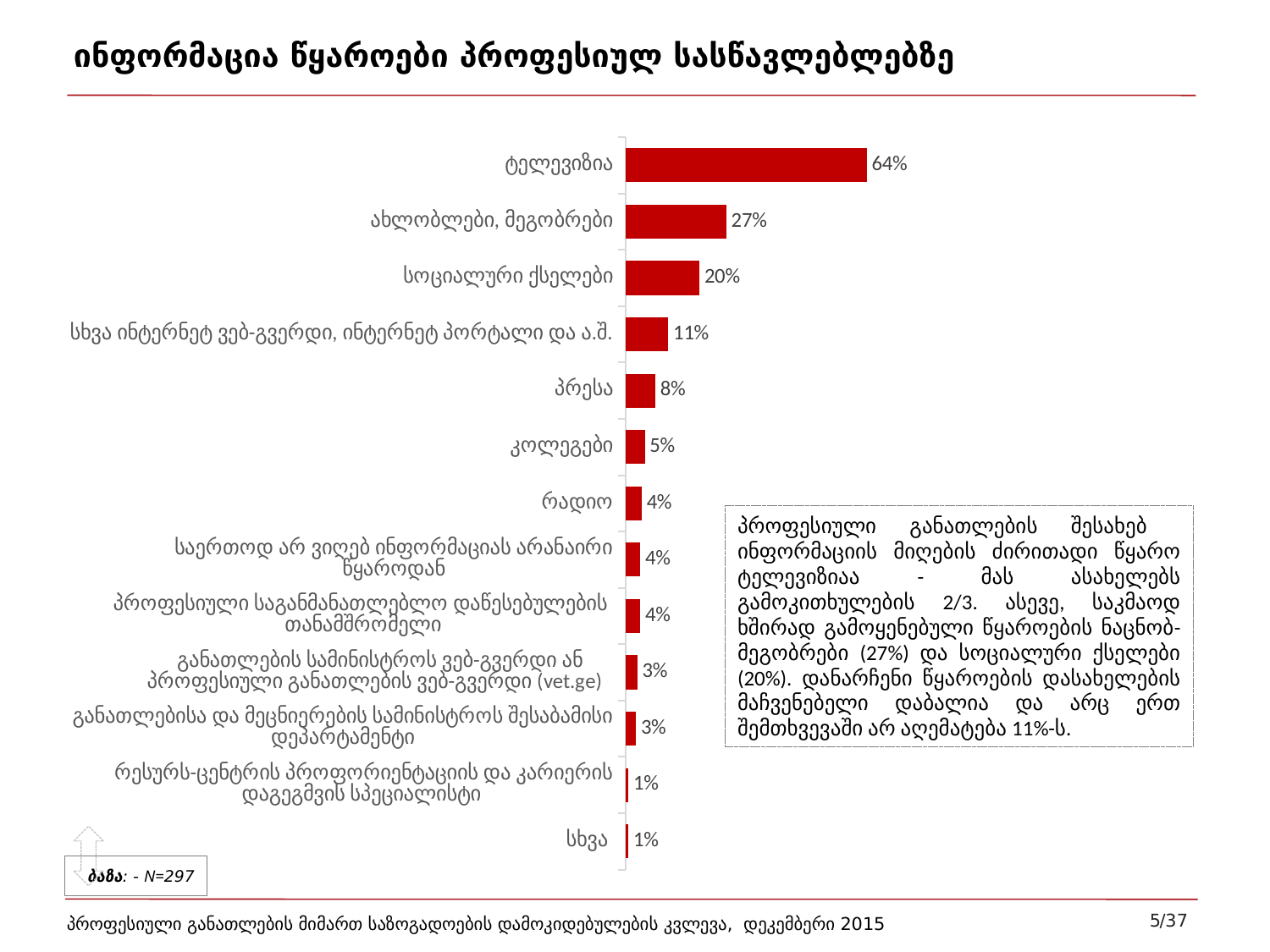
What type of chart is shown on the slide? Bar chart What value is shown for სოციალური ქსელები? 20% How many categories are shown in the chart? 13 What percentage is shown for პრესა? 8% What percentage is shown for ტელევიზია? 64% Which category has the highest value in the chart? ტელევიზია What sample size (N) is noted on the slide? N=297 Which has a larger value: ახლობლები, მეგობრები or სოციალური ქსელები? ახლობლები, მეგობრები What is the difference between the values for ტელევიზია and ახლობლები, მეგობრები? 37% Which has a larger value: პრესა or კოლეგები? პრესა What value is shown for რადიო? 4% What is the difference between the values for სოციალური ქსელები and კოლეგები? 15%